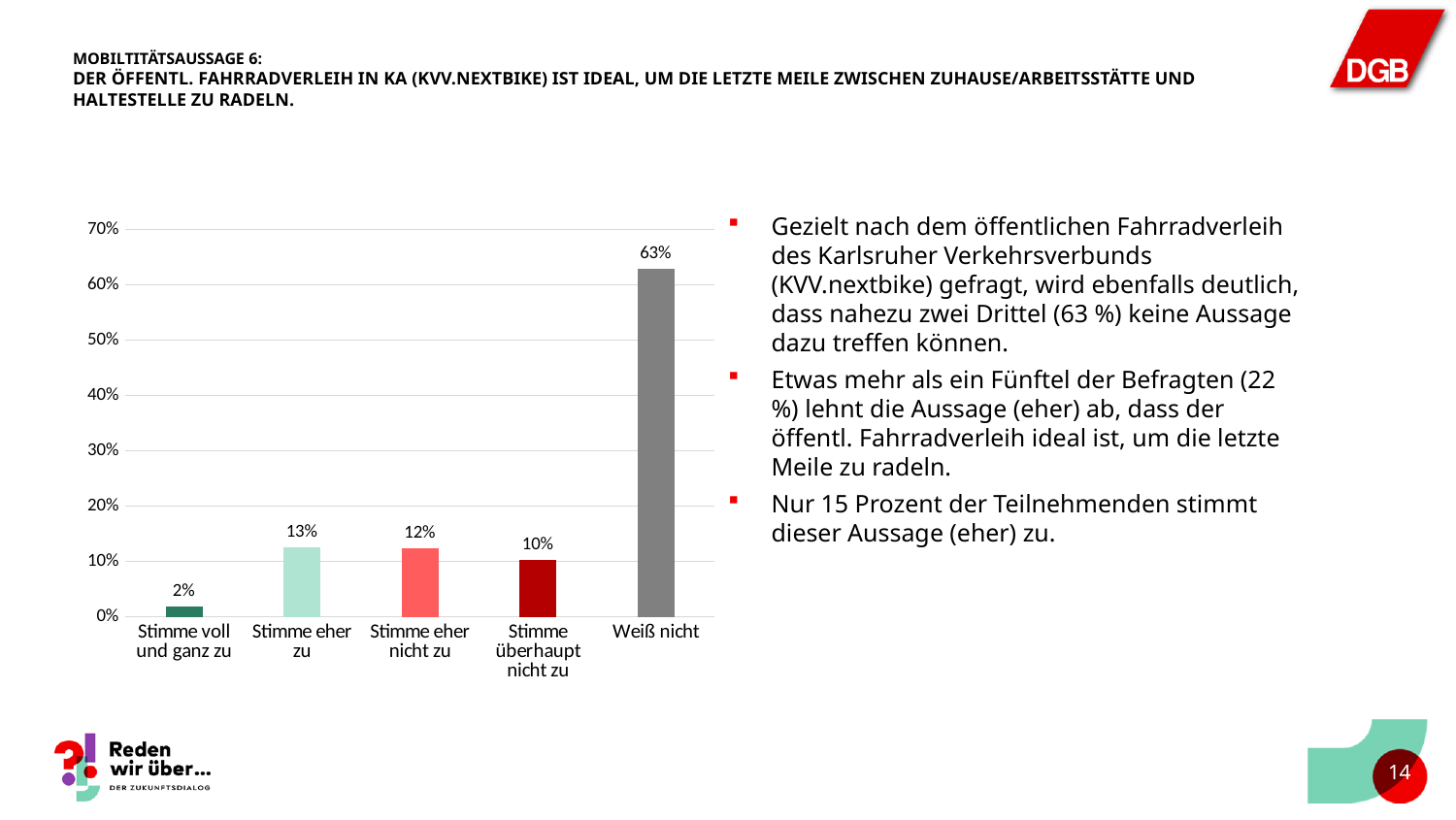
Is the value for "Weiß nicht" greater or less than 60%? greater Which category has the lowest value? Stimme voll und ganz zu What is the value for "Stimme eher zu"? 13% What kind of chart is shown on the slide? bar chart What colour is the bar for "Weiß nicht"? grey Which category has the highest value? Weiß nicht What is the value for "Stimme überhaupt nicht zu"? 10% What is the value for "Weiß nicht"? 63% Which is larger, "Stimme eher nicht zu" or "Stimme überhaupt nicht zu"? Stimme eher nicht zu What is the value for "Stimme voll und ganz zu"? 2% What is the difference between "Weiß nicht" and "Stimme eher zu"? 50% How many categories are shown on the x axis? 5